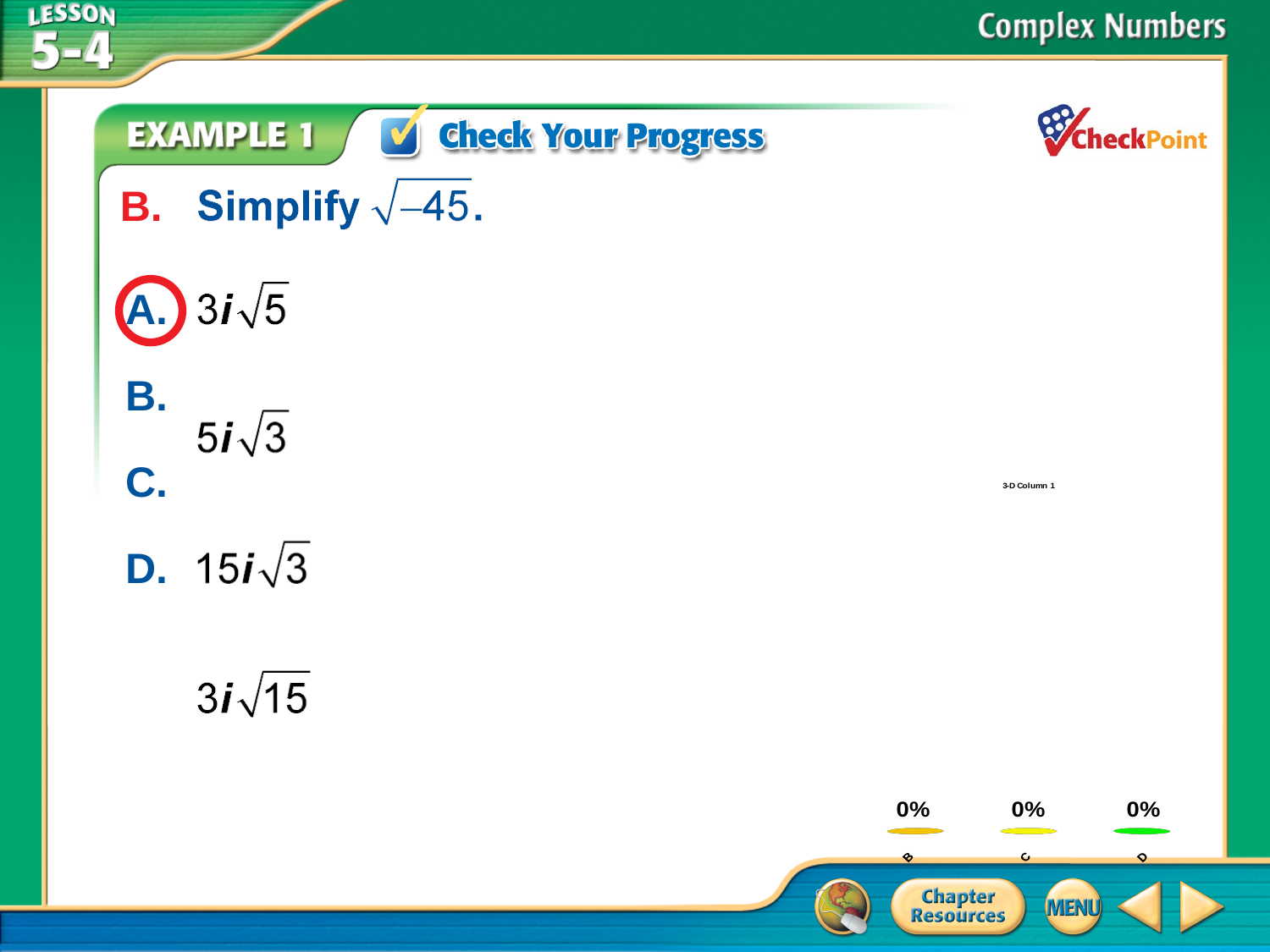
What kind of chart is shown at the bottom right of the slide? bar chart What is the difference between the values for categories C and D in the bottom-right chart? 0% What value is shown for category C in the chart at the bottom right of the slide? 0% What value is shown for category D in the chart at the bottom right of the slide? 0% Is the value for category C in the bottom-right chart larger than the value for category D, or are they equal? equal